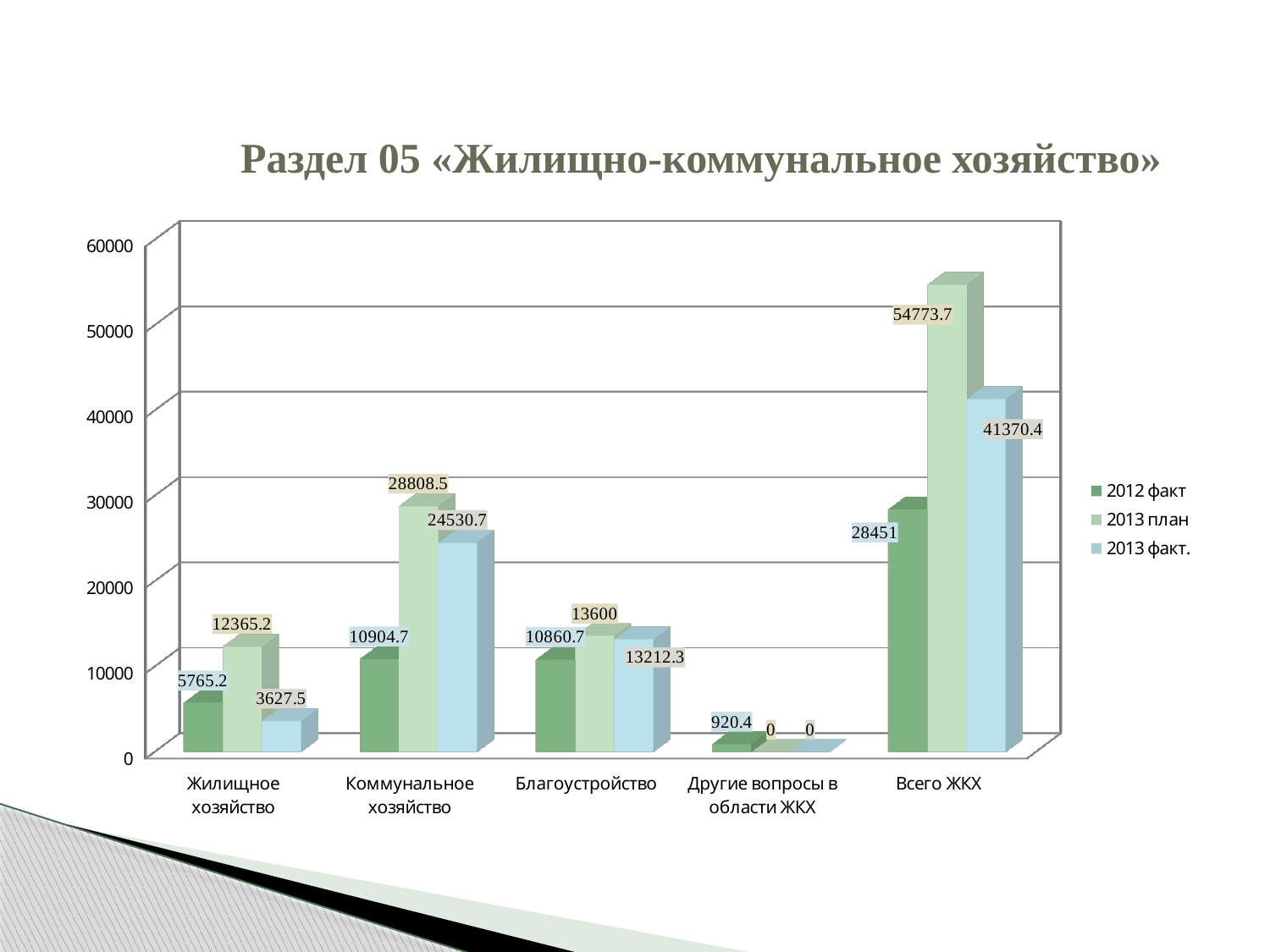
What is the 2013 факт. value for Всего ЖКХ? 41370.4 What kind of chart is shown on the slide? bar chart What is the 2013 факт. value for Другие вопросы в области ЖКХ? 0 How many series does the legend list? 3 What is the 2013 план value for Коммунальное хозяйство? 28808.5 What is the 2012 факт value for Жилищное хозяйство? 5765.2 Which category has the lowest 2012 факт value? Другие вопросы в области ЖКХ How many categories are shown on the x axis? 5 What is the difference between the 2013 план and 2013 факт. values for Всего ЖКХ? 13403.3 What is the title of the slide? Раздел 05 «Жилищно-коммунальное хозяйство» Which category has the highest 2013 план value? Всего ЖКХ Which is larger for Благоустройство: the 2013 план value or the 2013 факт. value? 2013 план